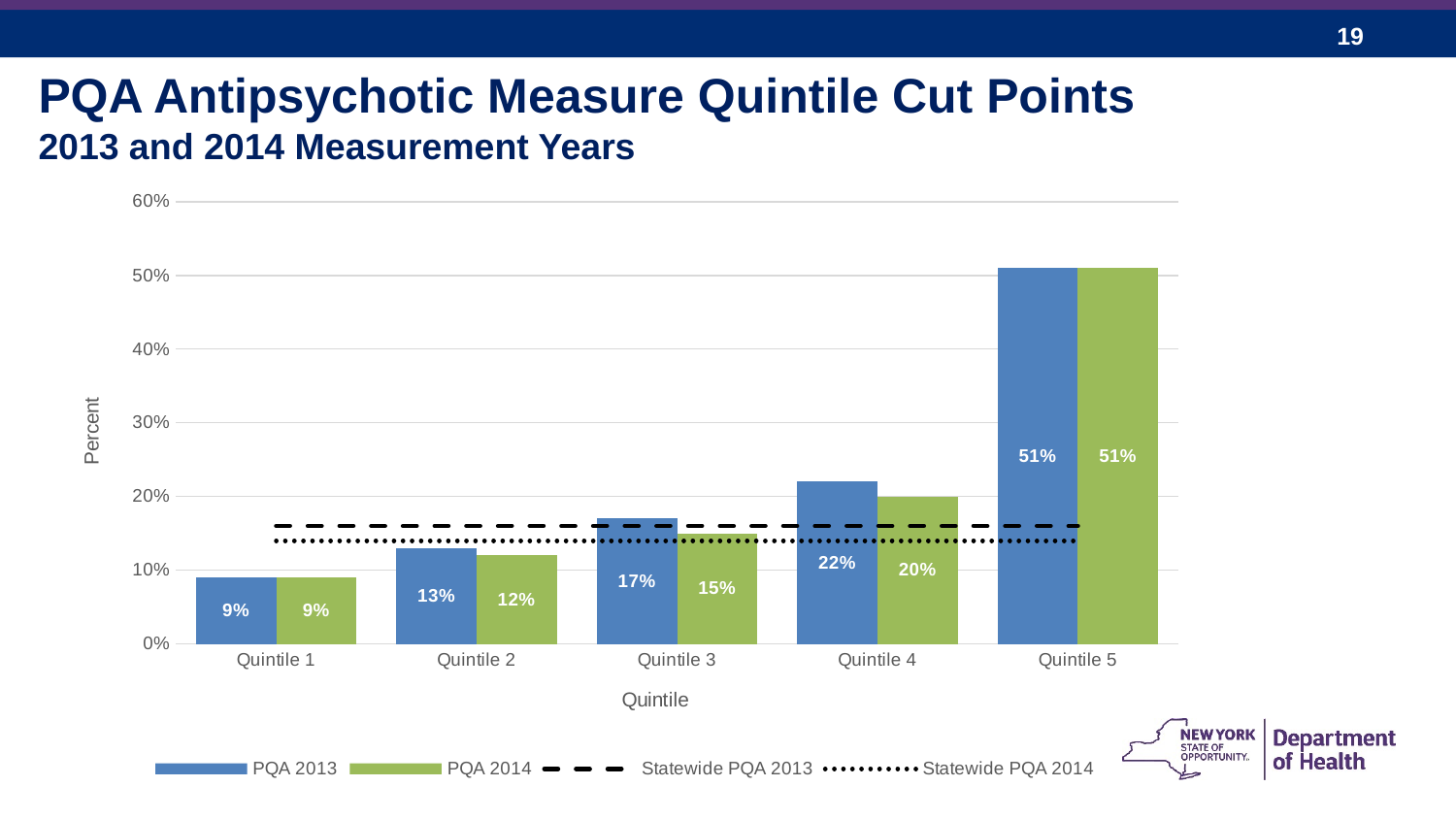
What is the difference between the PQA 2013 and PQA 2014 values for Quintile 4? 2% Which quintile has the lowest PQA 2014 value? Quintile 1 Do the PQA 2014 values rise or fall from Quintile 1 to Quintile 5? rise Is the Statewide PQA 2013 dashed line greater or less than 20%? less What is the PQA 2014 value for Quintile 2? 12% How many entries does the legend list? 4 What is the difference between the PQA 2013 values for Quintile 5 and Quintile 4? 29% What is the PQA 2013 value for Quintile 4? 22% Which is larger for Quintile 3, the PQA 2013 value or the PQA 2014 value? PQA 2013 Which quintile has the highest PQA 2013 value? Quintile 5 What is the PQA 2014 value for Quintile 3? 15% How many quintiles are shown on the x axis? 5